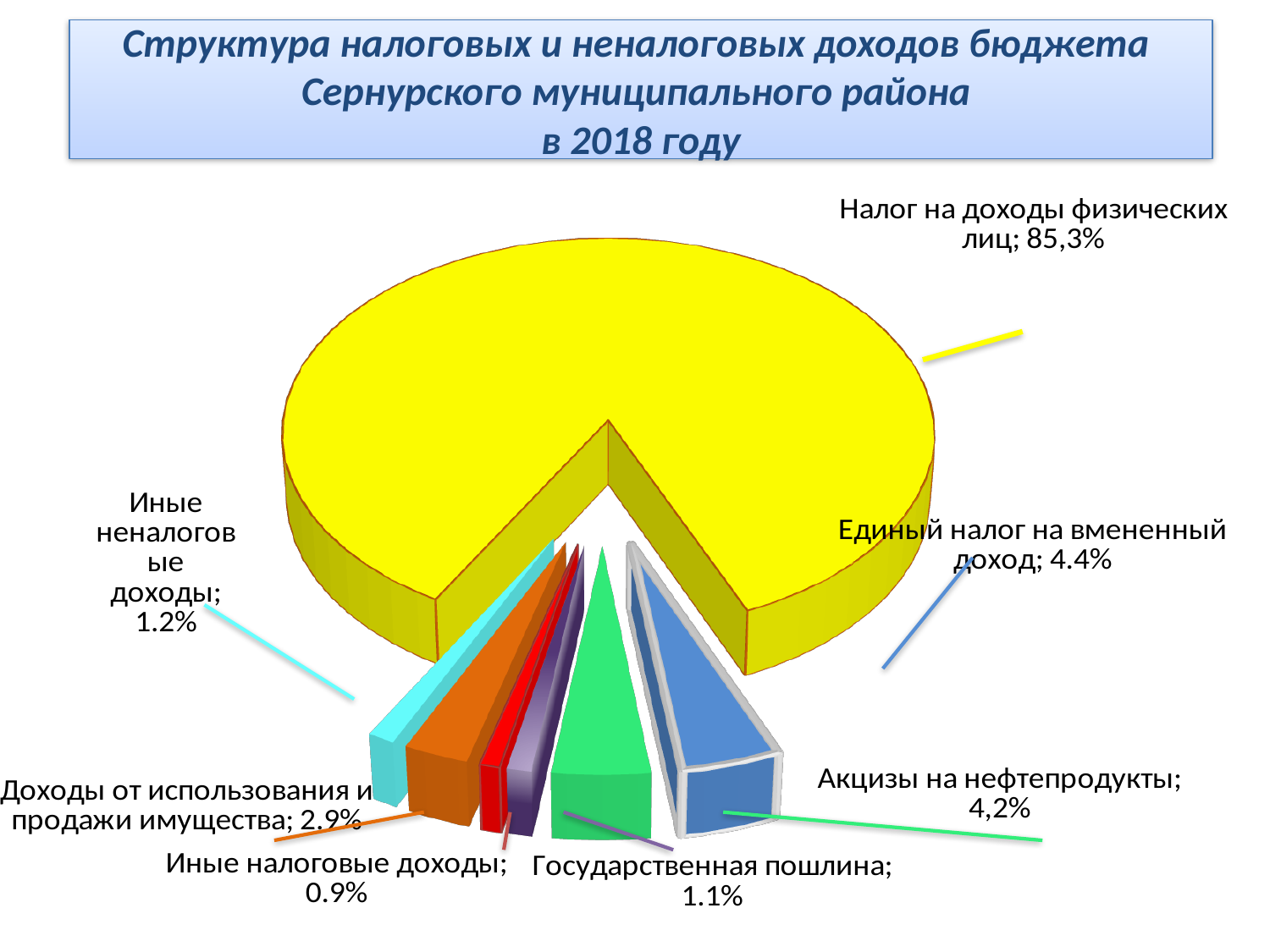
What is the value shown for Единый налог на вмененный доход? 4.4% Which category has the smallest share of the pie? Иные налоговые доходы What share of the budget revenue is Налог на доходы физических лиц? 85,3% What is the value shown for Акцизы на нефтепродукты? 4,2% What type of chart is shown on the slide? pie chart What is the value shown for Государственная пошлина? 1.1% What is the value shown for Иные неналоговые доходы? 1.2% Which category has the largest share of the pie? Налог на доходы физических лиц How many categories (slices) does the pie chart have? 7 Which is larger: Доходы от использования и продажи имущества or Иные неналоговые доходы? Доходы от использования и продажи имущества What year does the chart title refer to? 2018 What is the value shown for Доходы от использования и продажи имущества? 2.9%